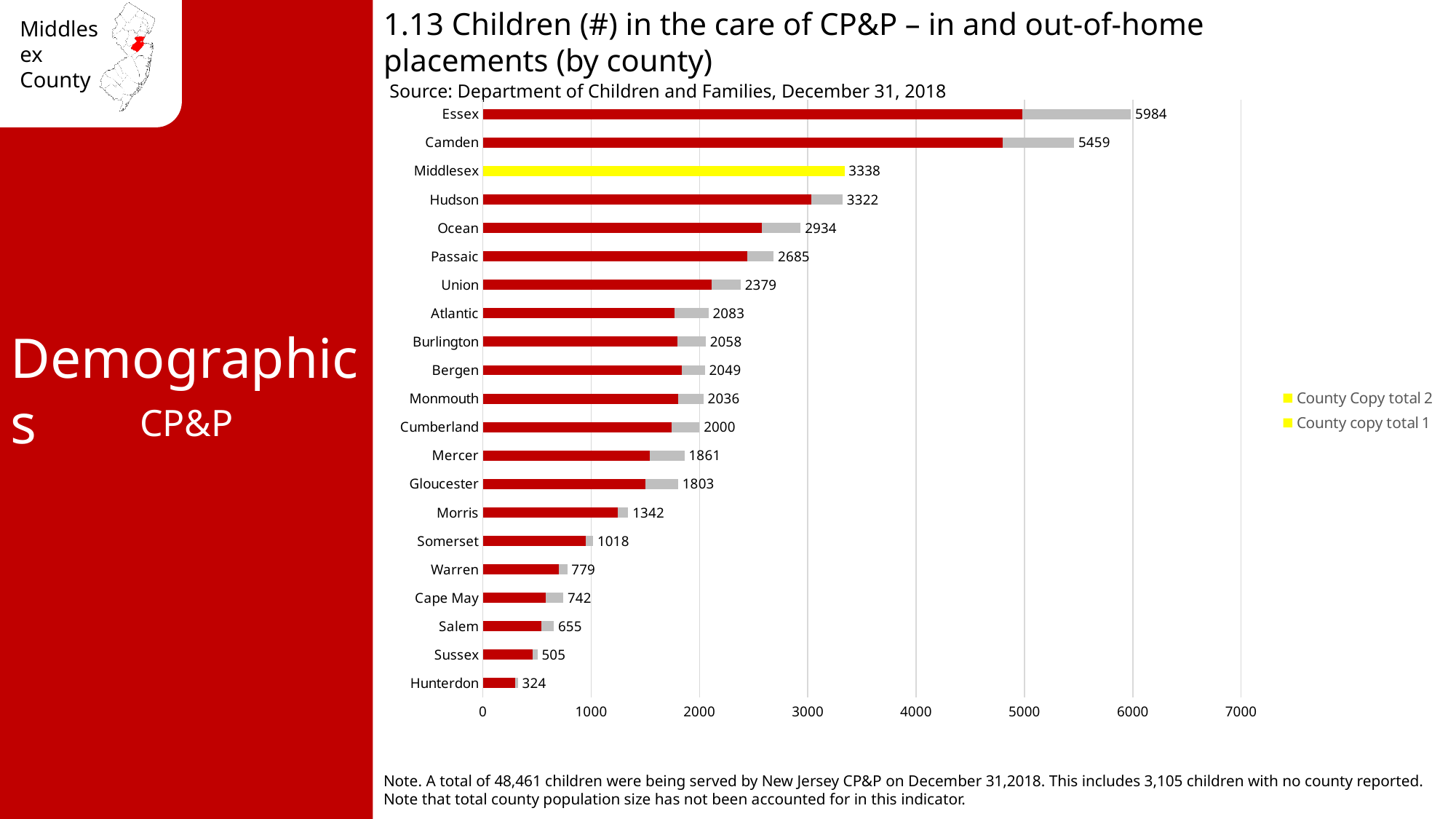
Which county has the lowest total on the chart? Hunterdon Which county has the highest total on the chart? Essex Is the red segment of the Essex bar greater or less than 4000? greater What is the difference between the totals for Essex and Camden? 525 What is the value shown for Hunterdon? 324 What is the difference between the totals for Morris and Somerset? 324 What value is labelled for Cumberland? 2000 What is the total number of children in the care of CP&P shown for Essex? 5984 What kind of chart is shown on the slide? Bar chart How many counties are listed on the chart? 21 What value is labelled for Middlesex on the chart? 3338 Which county has a larger total, Ocean or Passaic? Ocean